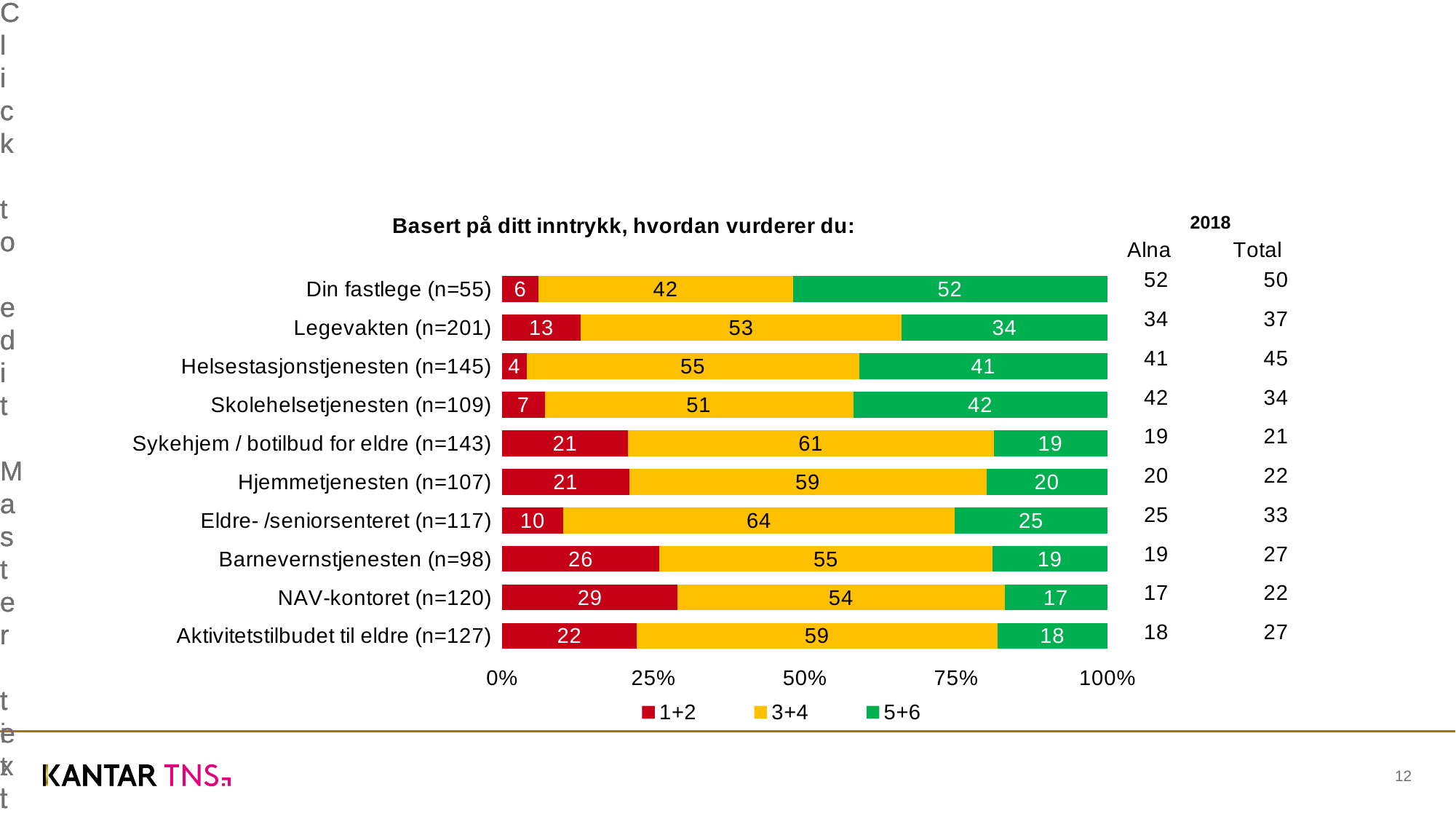
How many categories (services) are plotted in the chart? 10 Which category has the lowest 1+2 value? Helsestasjonstjenesten (n=145) What kind of chart is shown on the slide? Stacked bar chart How many series does the legend list? 3 What is the title of the chart? Basert på ditt inntrykk, hvordan vurderer du: Which category has the highest 5+6 value? Din fastlege (n=55) What is the 3+4 value for Eldre- /seniorsenteret (n=117)? 64 What is the 5+6 value for Din fastlege (n=55)? 52 Which category has the lowest 5+6 value? NAV-kontoret (n=120) Which is larger: the 1+2 value for Barnevernstjenesten (n=98) or for Aktivitetstilbudet til eldre (n=127)? Barnevernstjenesten (n=98) What is the 1+2 value for NAV-kontoret (n=120)? 29 What is the difference between the 5+6 values for Legevakten (n=201) and Hjemmetjenesten (n=107)? 14